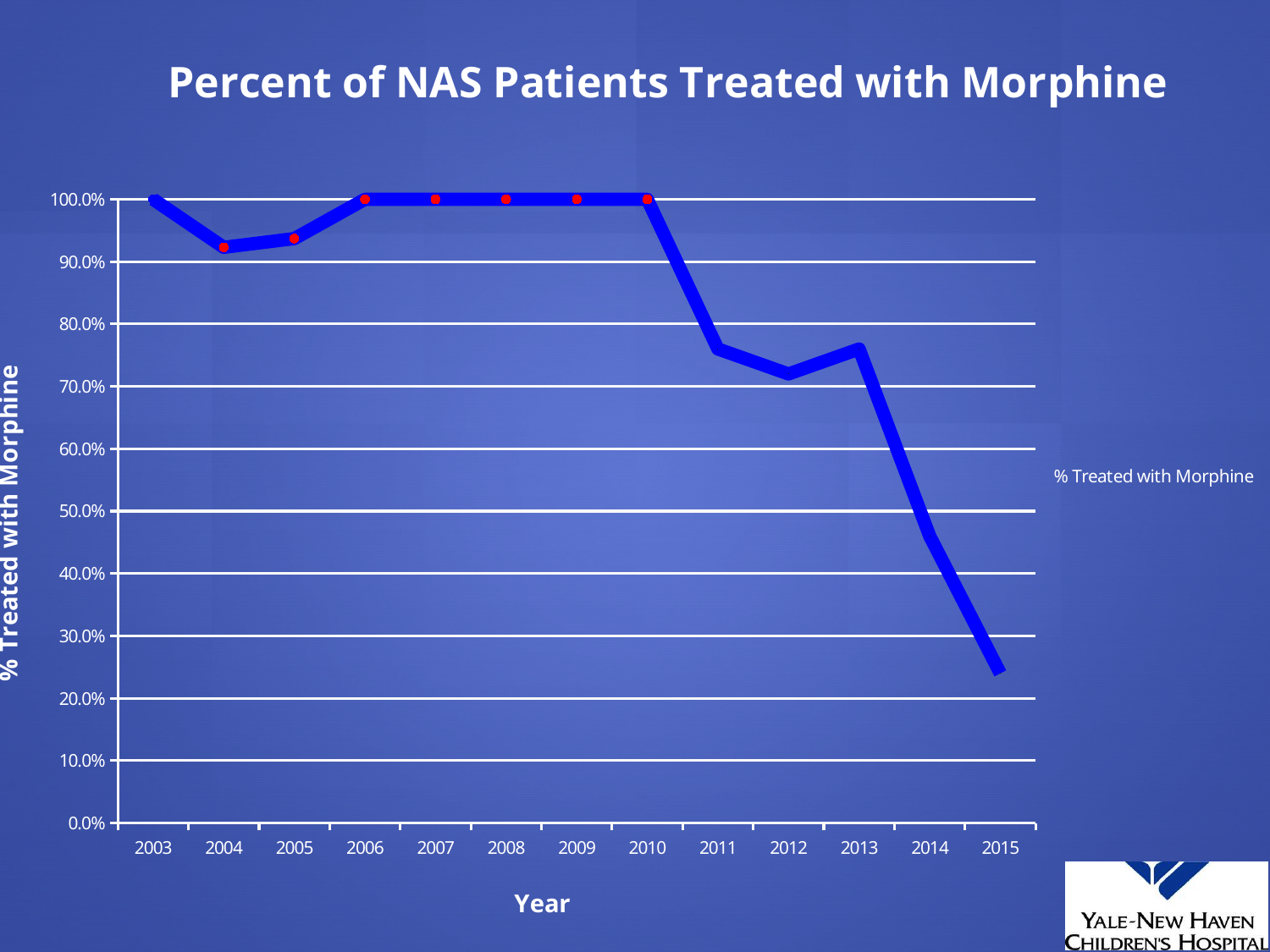
Is the value for 2014 greater or less than 50.0%? less Is the value for 2004 greater or less than 90.0%? greater What kind of chart is shown on the slide? line chart What is the title of the chart? Percent of NAS Patients Treated with Morphine How many series does the legend list? 1 Is the value for 2015 greater or less than 30.0%? less How many years are plotted along the x axis? 13 Which year has the lowest percent treated with morphine? 2015 Which is larger, the value for 2011 or the value for 2015? 2011 What is the value for 2007? 100.0% Do the values generally rise or fall from 2010 to 2015? fall